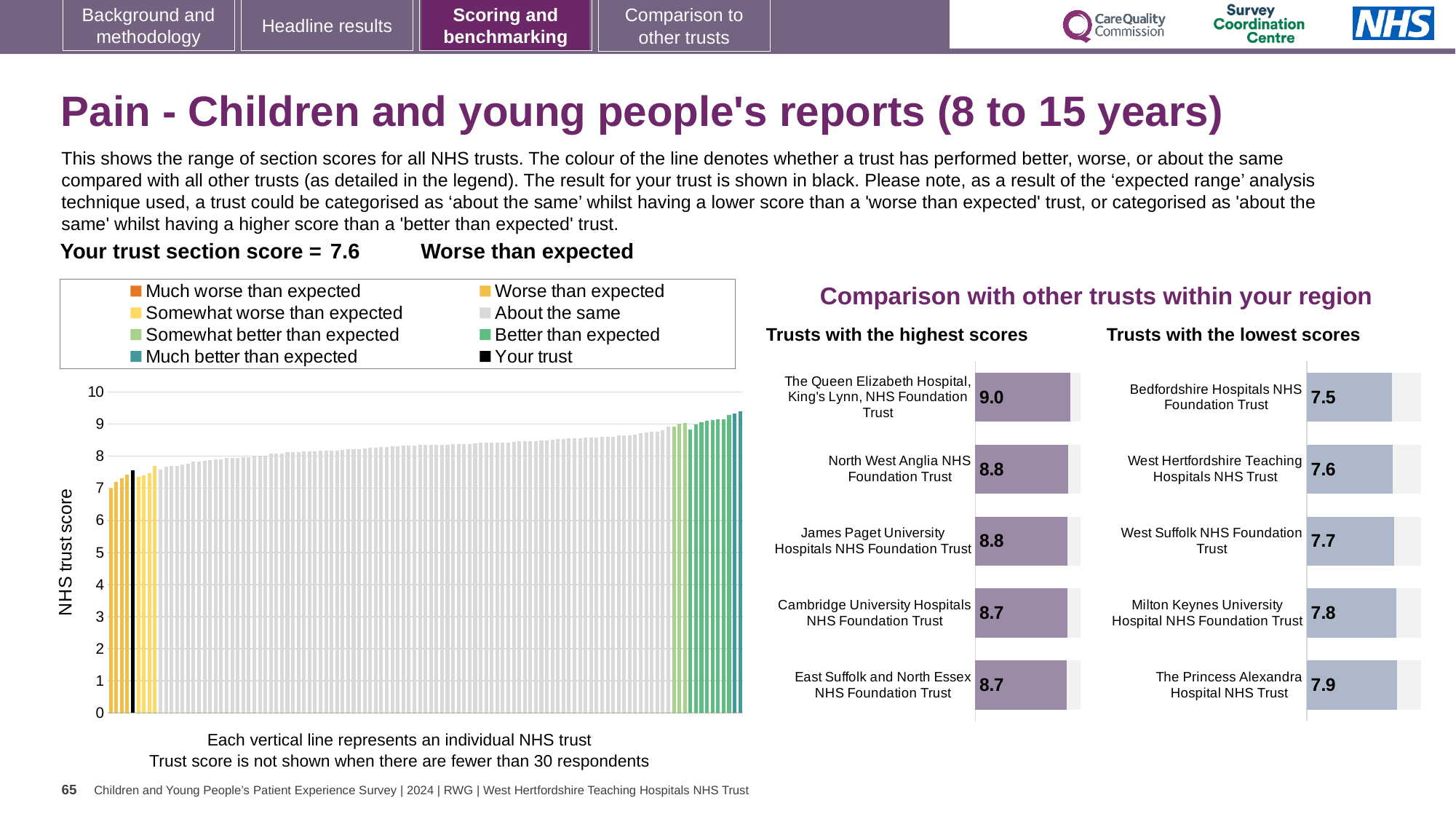
How many entries does the legend of the large chart on the left list? 8 In the large chart on the left, do the trust scores rise or fall from left to right? Rise In the 'Trusts with the lowest scores' chart, which trust has the lowest score? Bedfordshire Hospitals NHS Foundation Trust What kind of chart is the large chart on the left showing the range of section scores for all NHS trusts? Bar chart In the 'Trusts with the highest scores' chart, which trust has the highest score? The Queen Elizabeth Hospital, King's Lynn, NHS Foundation Trust How many trusts are shown in the 'Trusts with the lowest scores' chart? 5 In the 'Trusts with the highest scores' chart, what is the score for Cambridge University Hospitals NHS Foundation Trust? 8.7 In the 'Trusts with the lowest scores' chart, what is the difference between the scores of The Princess Alexandra Hospital NHS Trust and Bedfordshire Hospitals NHS Foundation Trust? 0.4 In the 'Trusts with the lowest scores' chart, which has the larger score: Milton Keynes University Hospital NHS Foundation Trust or West Suffolk NHS Foundation Trust? Milton Keynes University Hospital NHS Foundation Trust In the 'Trusts with the highest scores' chart, what is the difference between the scores of The Queen Elizabeth Hospital, King's Lynn and East Suffolk and North Essex NHS Foundation Trust? 0.3 In the 'Trusts with the highest scores' chart, what is the score for The Queen Elizabeth Hospital, King's Lynn, NHS Foundation Trust? 9.0 In the 'Trusts with the lowest scores' chart, what is the score for Bedfordshire Hospitals NHS Foundation Trust? 7.5